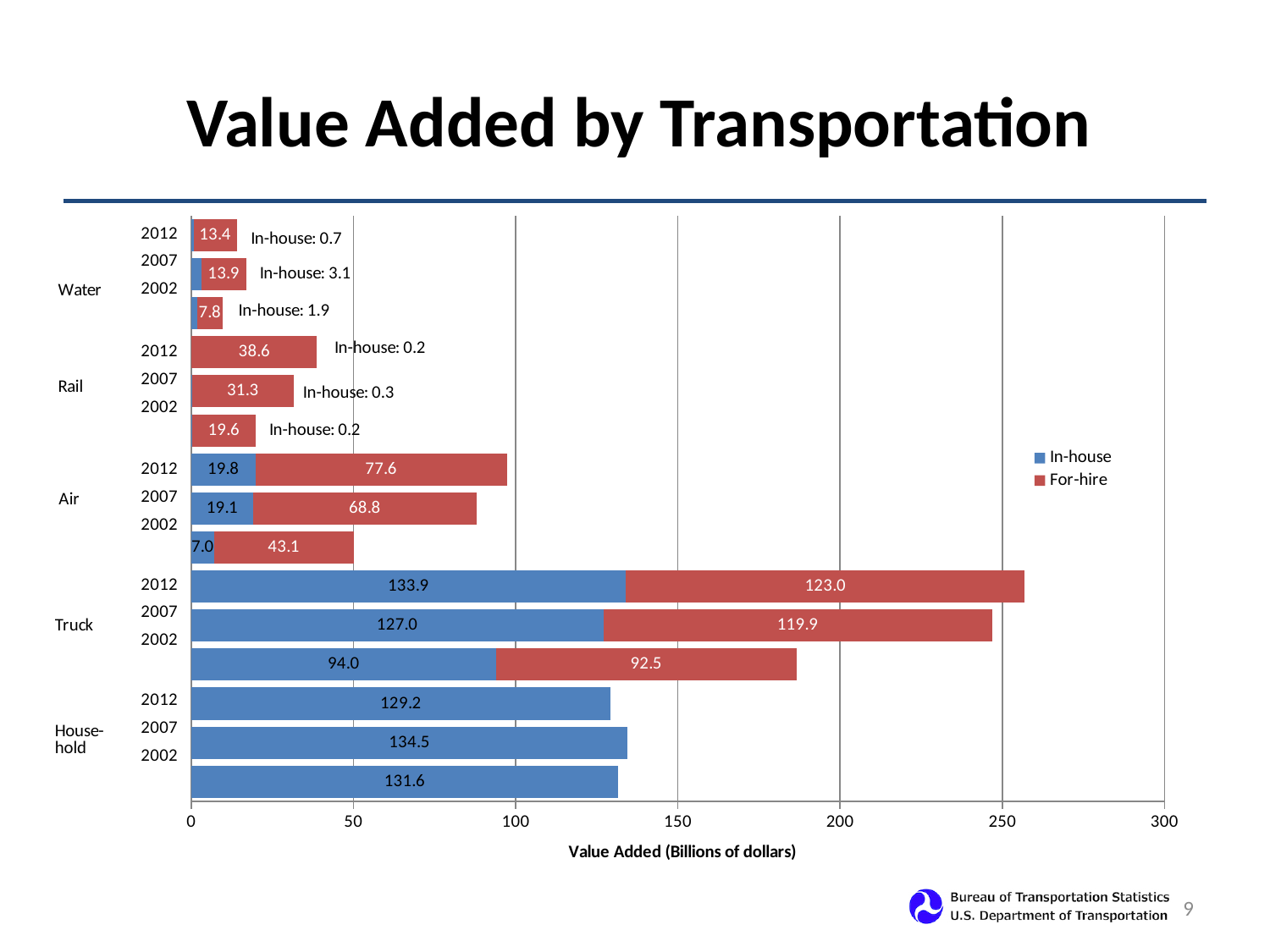
What is the For-hire value for Air in 2007? 68.8 Which year has the highest Household value? 2007 How many series does the legend list? 2 Is the total value added for Truck in 2007 greater or less than 200? greater Which year has the lowest For-hire value for Water? 2002 Which is larger: the For-hire value for Air in 2012 or the For-hire value for Rail in 2012? Air in 2012 What is the In-house value for Water in 2007? 3.1 What is the total value added for Truck in 2012 (In-house plus For-hire)? 256.9 What kind of chart is shown on the slide? Stacked bar chart What is the In-house value for Truck in 2012? 133.9 What is the difference between the For-hire value for Truck in 2012 and the For-hire value for Truck in 2002? 30.5 What is the title of the x axis? Value Added (Billions of dollars)